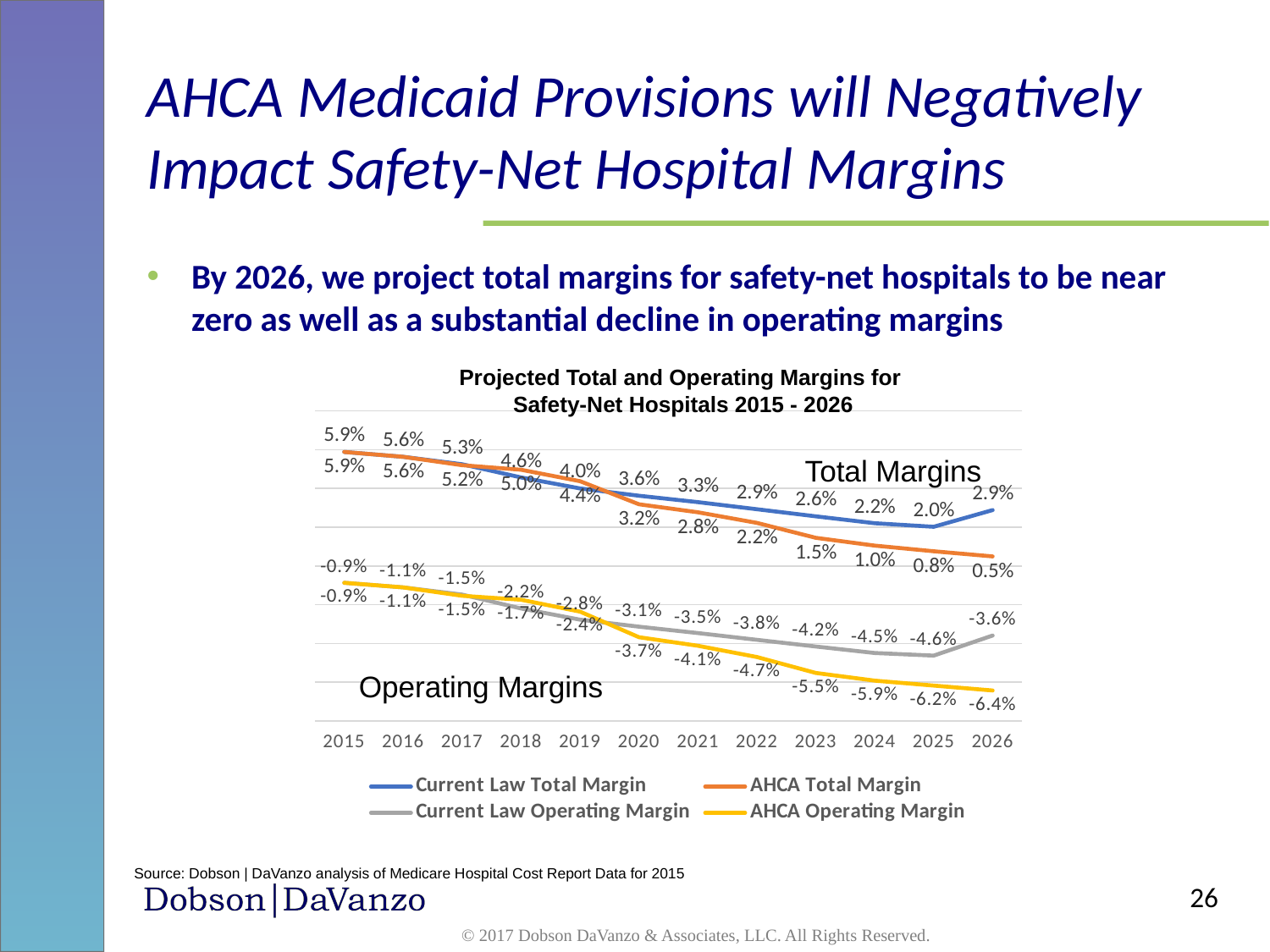
How many years are plotted along the x axis of the chart? 12 What is the AHCA Operating Margin in 2026? -6.4% In which year is the AHCA Operating Margin lowest? 2026 Which is larger in 2026, the Current Law Total Margin or the AHCA Total Margin? Current Law Total Margin What kind of chart is shown on the slide? Line chart What is the AHCA Total Margin in 2026? 0.5% Does the AHCA Total Margin rise or fall from 2015 to 2026? Fall What is the difference between the Current Law Total Margin and the AHCA Total Margin in 2026? 2.4 percentage points What is the Current Law Operating Margin in 2025? -4.6% How many series does the chart legend list? 4 What is the Current Law Total Margin in 2026? 2.9% In which year is the Current Law Total Margin highest? 2015